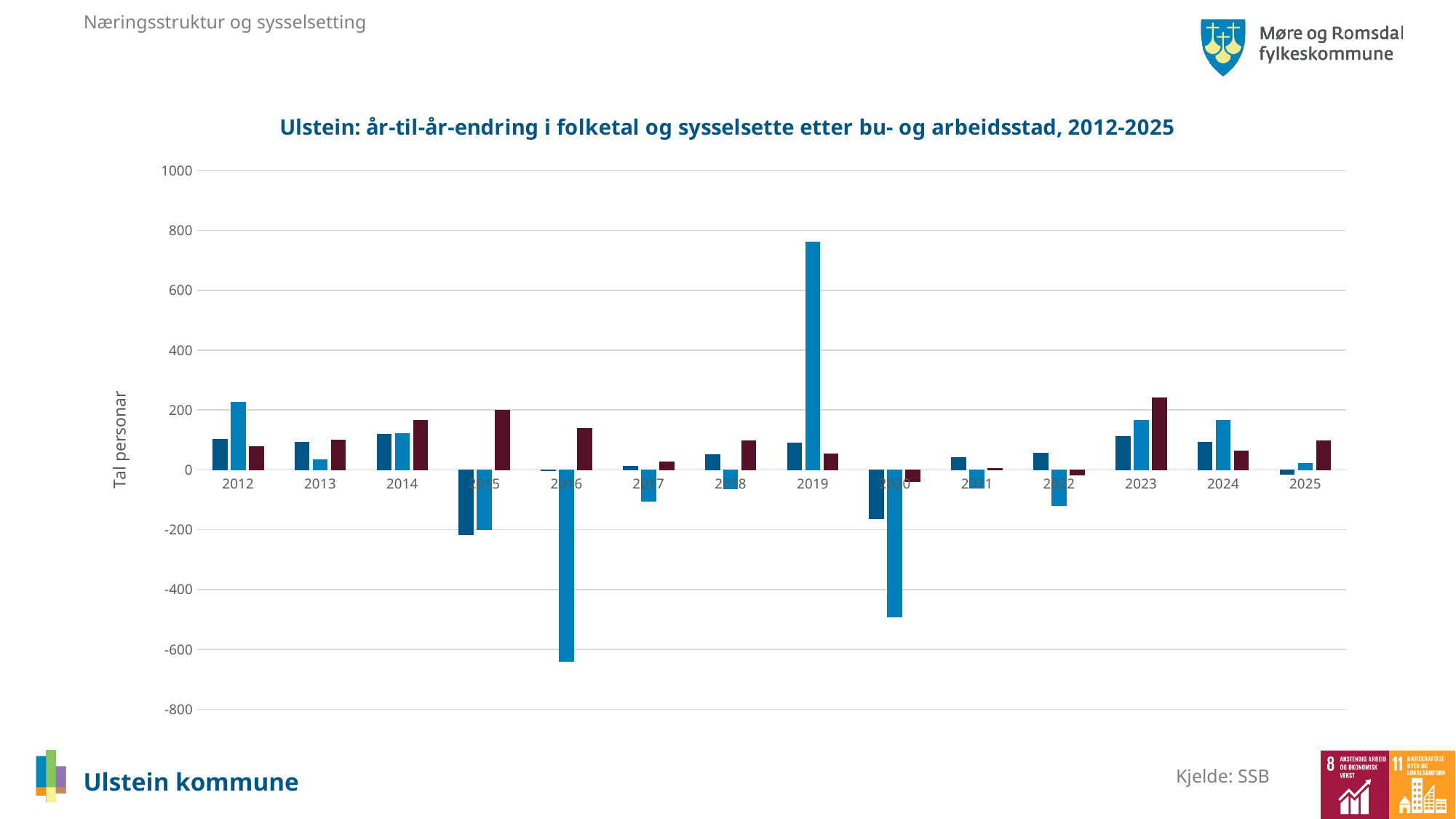
In which year is the light blue bar the highest? 2019 Is the light blue bar for 2016 greater or less than -400? less Is the light blue bar for 2020 greater or less than -400? less Which is larger, the light blue bar for 2012 or the light blue bar for 2013? 2012 In which year is the dark red bar the highest? 2023 How many bars are plotted for each year in the chart? 3 Is the dark blue bar for 2020 greater or less than -100? less What kind of chart is shown on the slide? bar chart How many years are shown along the x axis of the chart? 14 What is the label on the vertical axis of the chart? Tal personar In which year is the light blue bar the lowest (most negative)? 2016